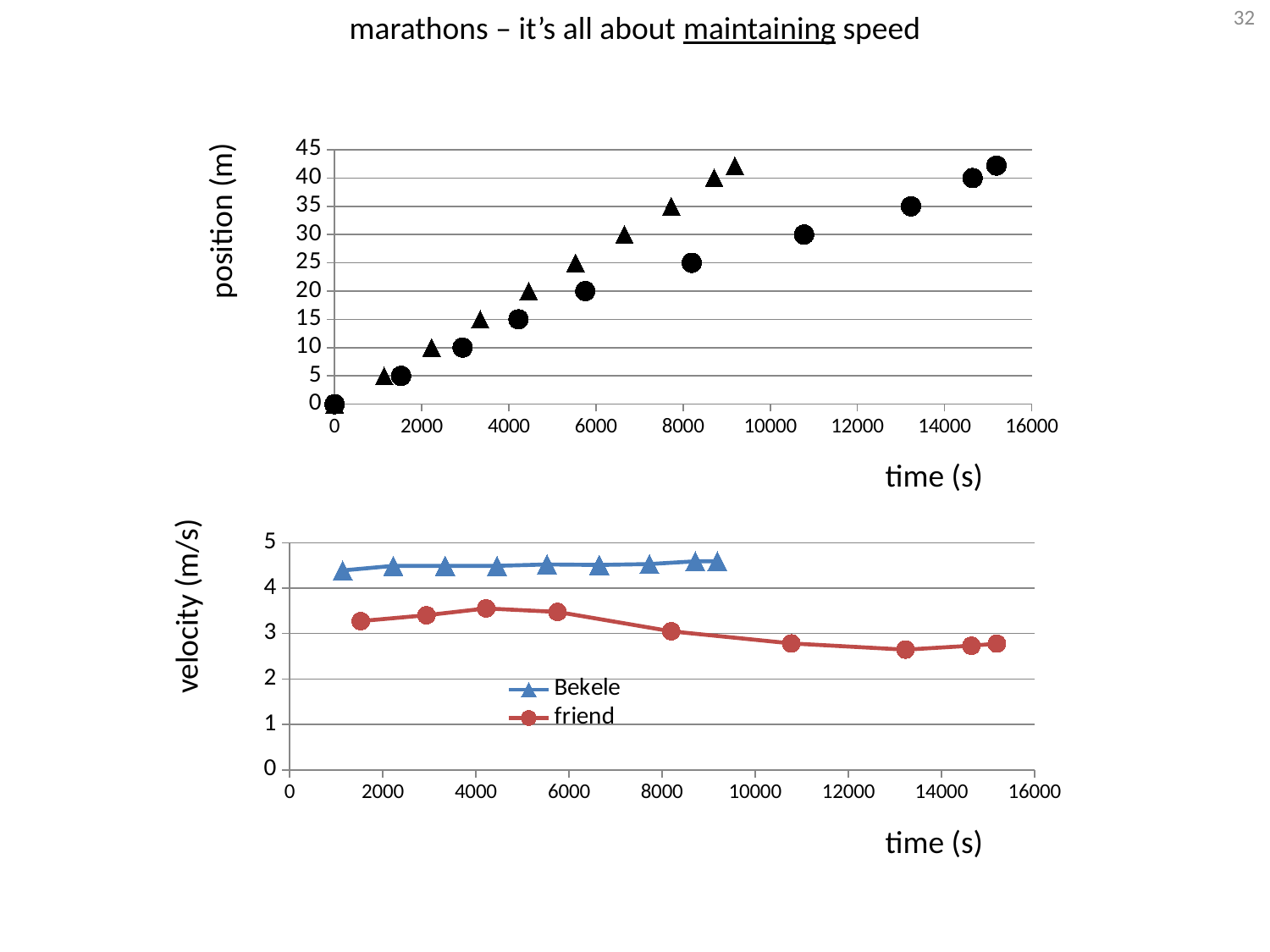
How many circle data points are plotted in the top chart (position vs time)? 10 In the top chart (position vs time), which series reaches 40 m at an earlier time, the triangles or the circles? triangles In the top chart (position vs time), does position rise or fall as time increases? rise In the bottom chart (velocity vs time), is the friend's lowest velocity greater or less than 3 m/s? less In the bottom chart (velocity vs time), does the friend's velocity rise or fall between about 6000 s and 14000 s? fall In the bottom chart (velocity vs time), which series has the higher velocity, Bekele or friend? Bekele How many series does the legend of the bottom chart (velocity vs time) list? 2 In the bottom chart (velocity vs time), is Bekele's velocity greater or less than 4 m/s? greater What is the y-axis label of the top chart? position (m) How many data points are plotted for the friend series in the bottom chart (velocity vs time)? 9 What kind of chart is the bottom chart (velocity vs time)? line chart What are the two series named in the legend of the bottom chart (velocity vs time)? Bekele and friend